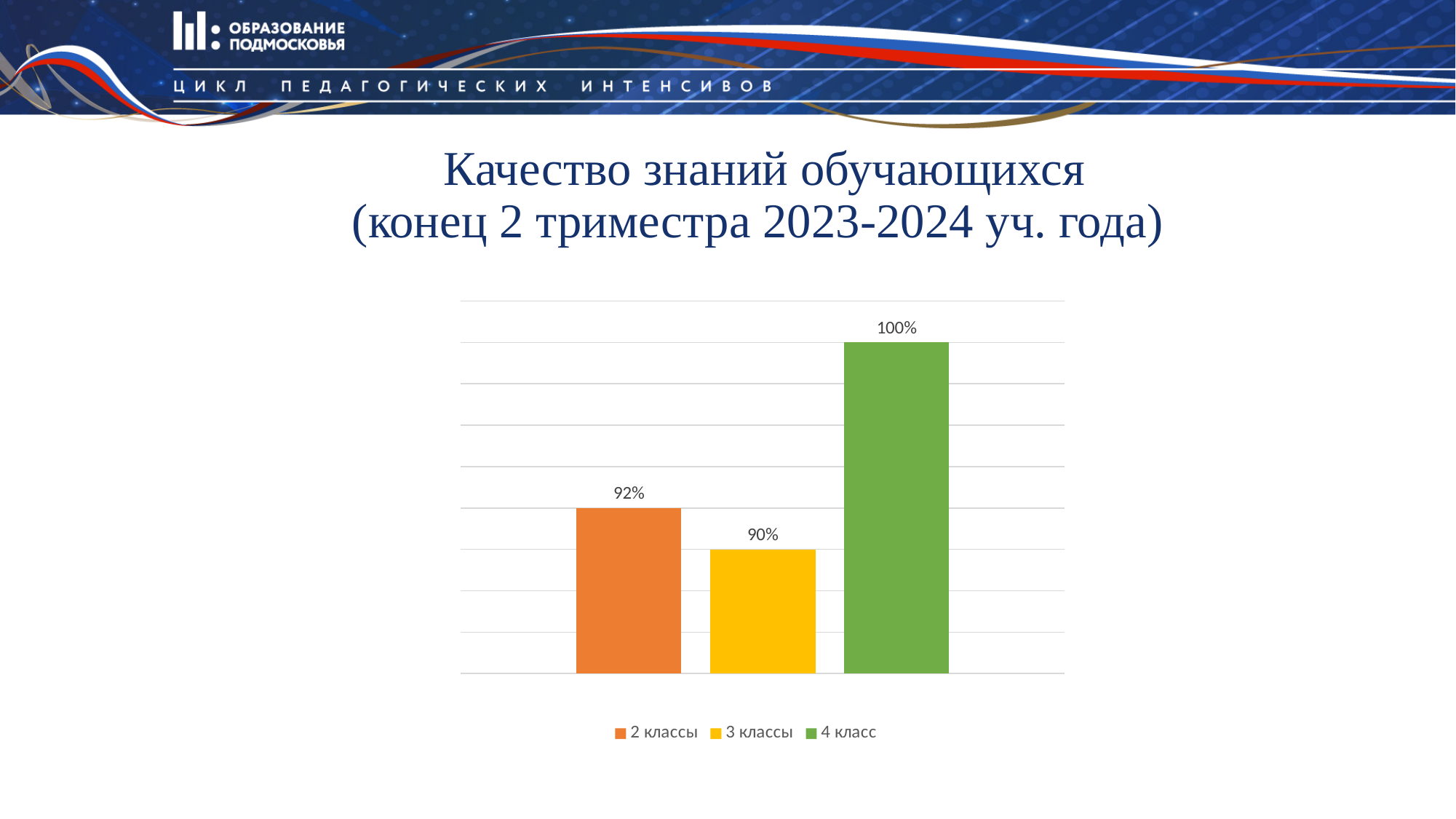
What is the value for 3 классы? 90% What is the difference between the values for 2 классы and 3 классы? 2% What is the value for 2 классы? 92% Which is larger, the value for 2 классы or the value for 3 классы? 2 классы How many bars are plotted in the chart? 3 What colour is the bar for 4 класс? Green How many series does the legend list? 3 Which series has the lowest value? 3 классы What is the value for 4 класс? 100% What is the difference between the values for 4 класс and 2 классы? 8% What kind of chart is shown on the slide? Bar chart Which series has the highest value? 4 класс